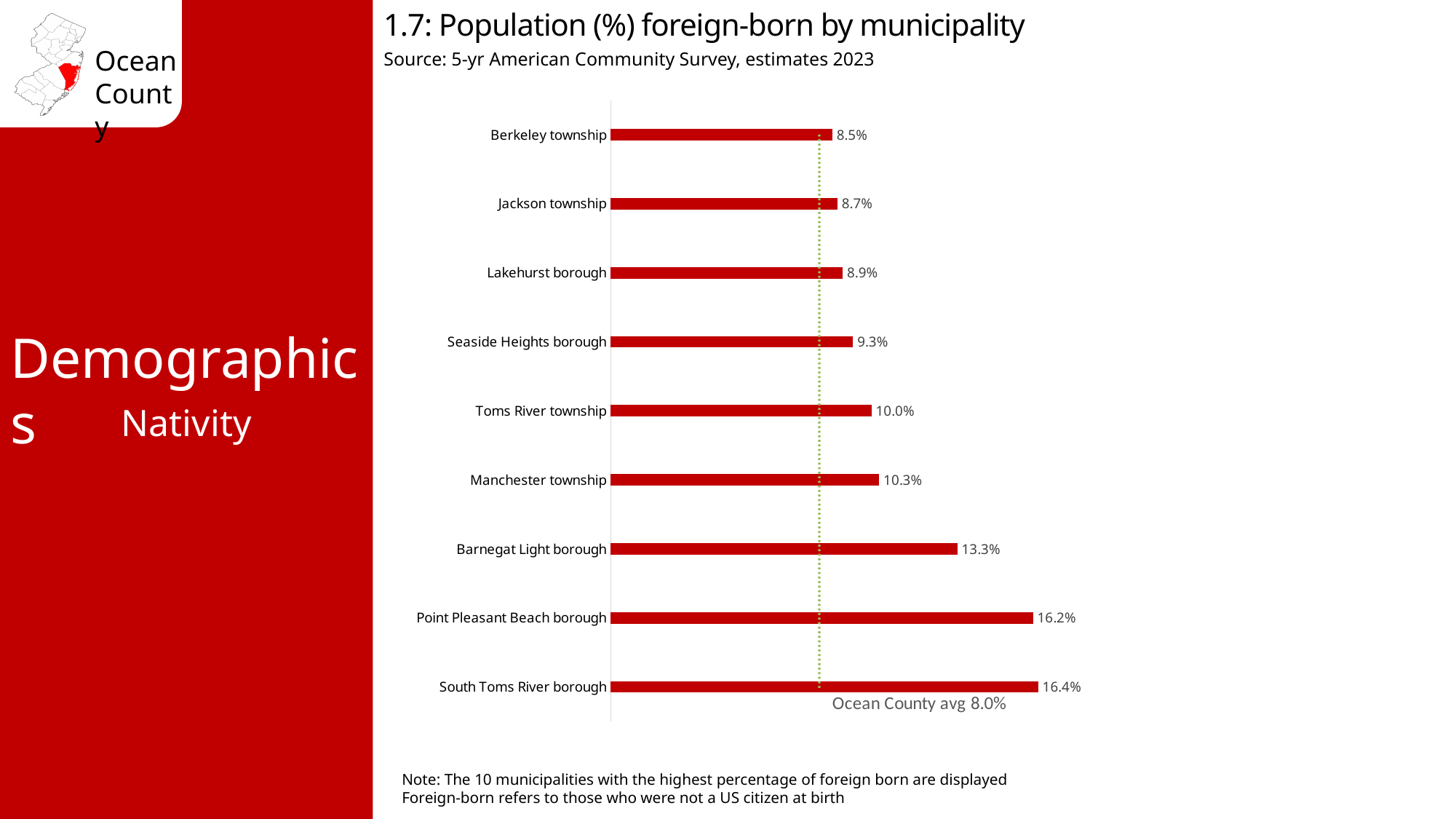
How many municipalities are plotted as bars on the chart? 9 What percentage of the population is foreign-born in Toms River township? 10.0% Which municipality has the highest foreign-born percentage on the chart? South Toms River borough What is the source of the data shown in the chart? 5-yr American Community Survey, estimates 2023 What is the Ocean County average foreign-born percentage marked by the dotted line? 8.0% What type of chart is used on this slide? Bar chart What is the difference between the foreign-born percentages of Point Pleasant Beach borough and Manchester township? 5.9% What is the difference between South Toms River borough and Berkeley township foreign-born percentages? 7.9% What value is shown for Lakehurst borough? 8.9% Which municipality has the lowest foreign-born percentage on the chart? Berkeley township Which has a higher foreign-born percentage, Seaside Heights borough or Jackson township? Seaside Heights borough What is the foreign-born percentage shown for Barnegat Light borough? 13.3%